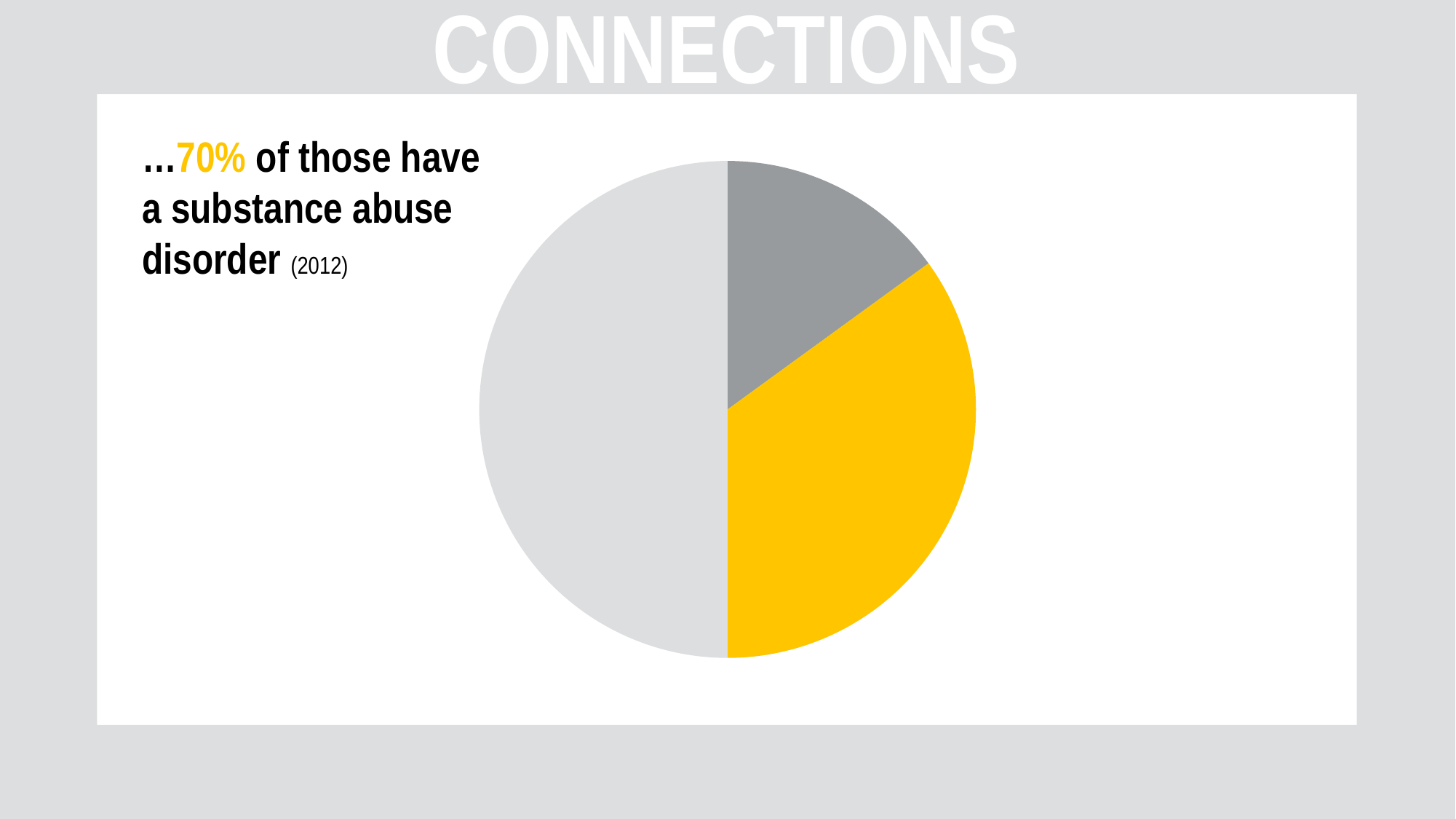
How many slices does the pie chart have? 3 What kind of chart is shown on the slide? pie chart What percentage is highlighted in yellow in the text next to the pie chart? 70% Which slice of the pie chart is the smallest? the dark gray slice Which is larger, the light gray slice or the yellow slice? the light gray slice What is the title at the top of the slide? CONNECTIONS Which is larger, the yellow slice or the dark gray slice? the yellow slice Which slice of the pie chart is the largest? the light gray slice Is the dark gray slice's share of the pie greater or less than 25%? less Is the light gray slice's share of the pie greater or less than 25%? greater Is the yellow slice's share of the pie greater or less than 50%? less